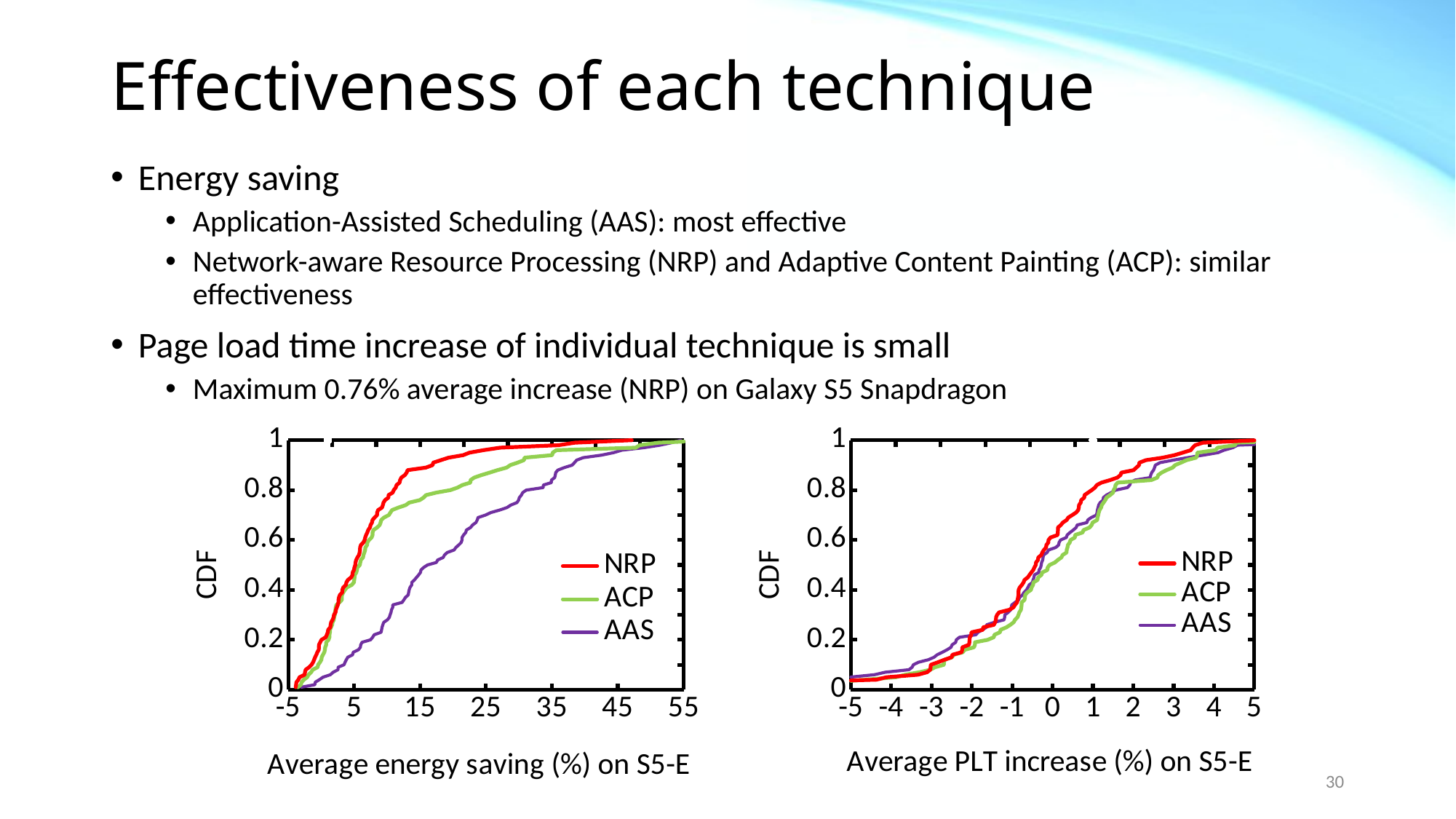
What kind of chart is the left chart, 'Average energy saving (%) on S5-E'? line chart In the right chart, 'Average PLT increase (%) on S5-E', is the CDF value for NRP at a PLT increase of 3% greater or less than 0.8? greater How many series does the legend of the right chart, 'Average PLT increase (%) on S5-E', list? 3 In the left chart, 'Average energy saving (%) on S5-E', is the CDF value for AAS at an energy saving of 5% greater or less than 0.2? less In the left chart, 'Average energy saving (%) on S5-E', which series reaches a CDF of 0.8 at the largest energy saving value? AAS In the right chart, 'Average PLT increase (%) on S5-E', is the CDF value for ACP at a PLT increase of -3% greater or less than 0.2? less In the left chart, 'Average energy saving (%) on S5-E', which series has the higher CDF value at an energy saving of 15%, NRP or AAS? NRP In the left chart, 'Average energy saving (%) on S5-E', which series is drawn in purple? AAS How many series does the legend of the left chart, 'Average energy saving (%) on S5-E', list? 3 What is the y-axis label of the right chart, 'Average PLT increase (%) on S5-E'? CDF